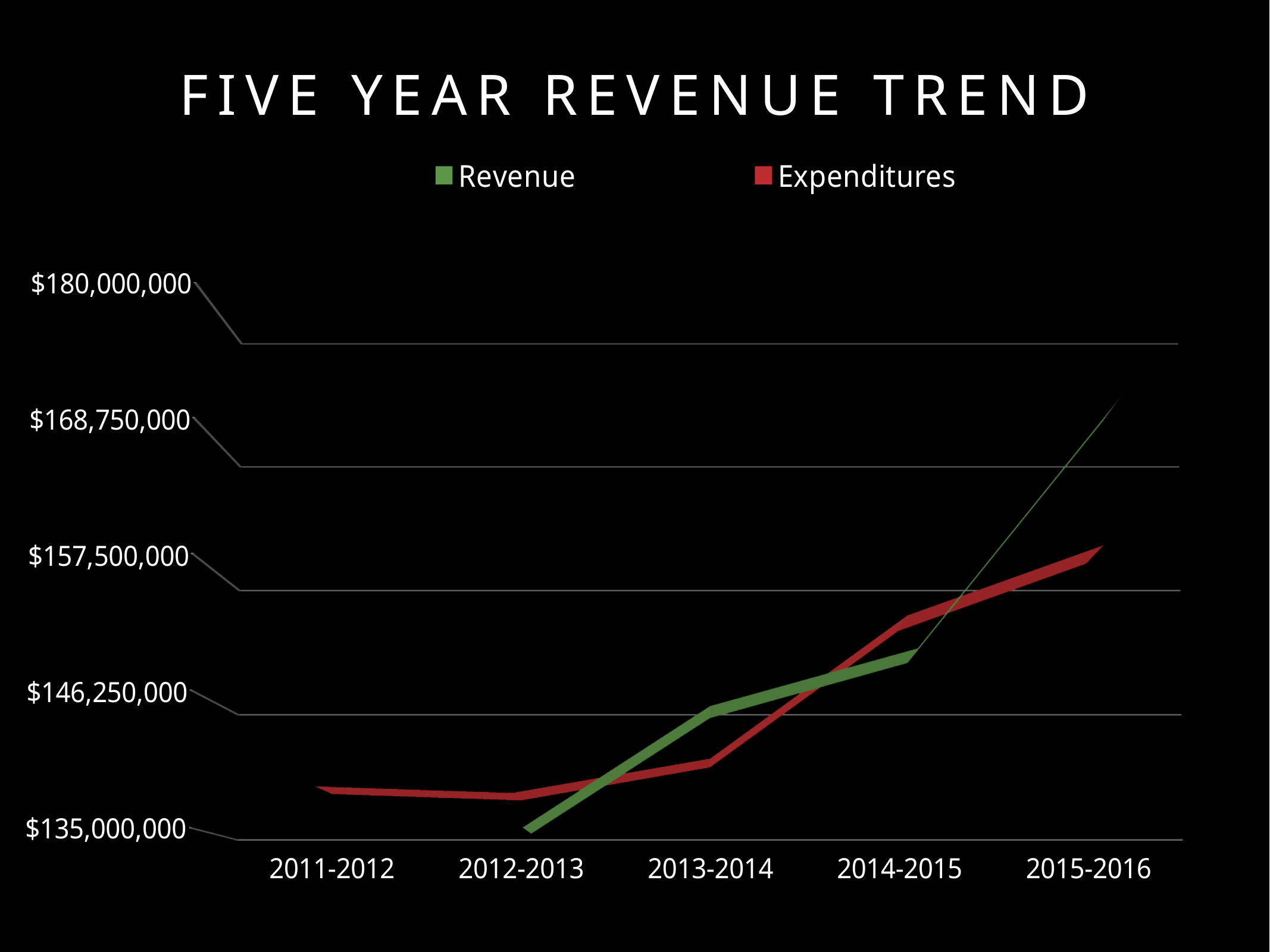
Is the value for Revenue in 2014-2015 greater or less than $146,250,000? greater Is the value for Expenditures in 2014-2015 greater or less than $146,250,000? greater How many series does the legend list? 2 What is the title of the chart? FIVE YEAR REVENUE TREND What kind of chart is shown on the slide? Line chart Is the value for Expenditures in 2011-2012 greater or less than $146,250,000? less How many fiscal years are shown on the x axis? 5 Do Expenditures generally rise or fall from 2012-2013 to 2015-2016? Rise Which colour represents Expenditures in the chart? Red In 2013-2014, which is larger, Revenue or Expenditures? Revenue In 2014-2015, which is larger, Revenue or Expenditures? Expenditures